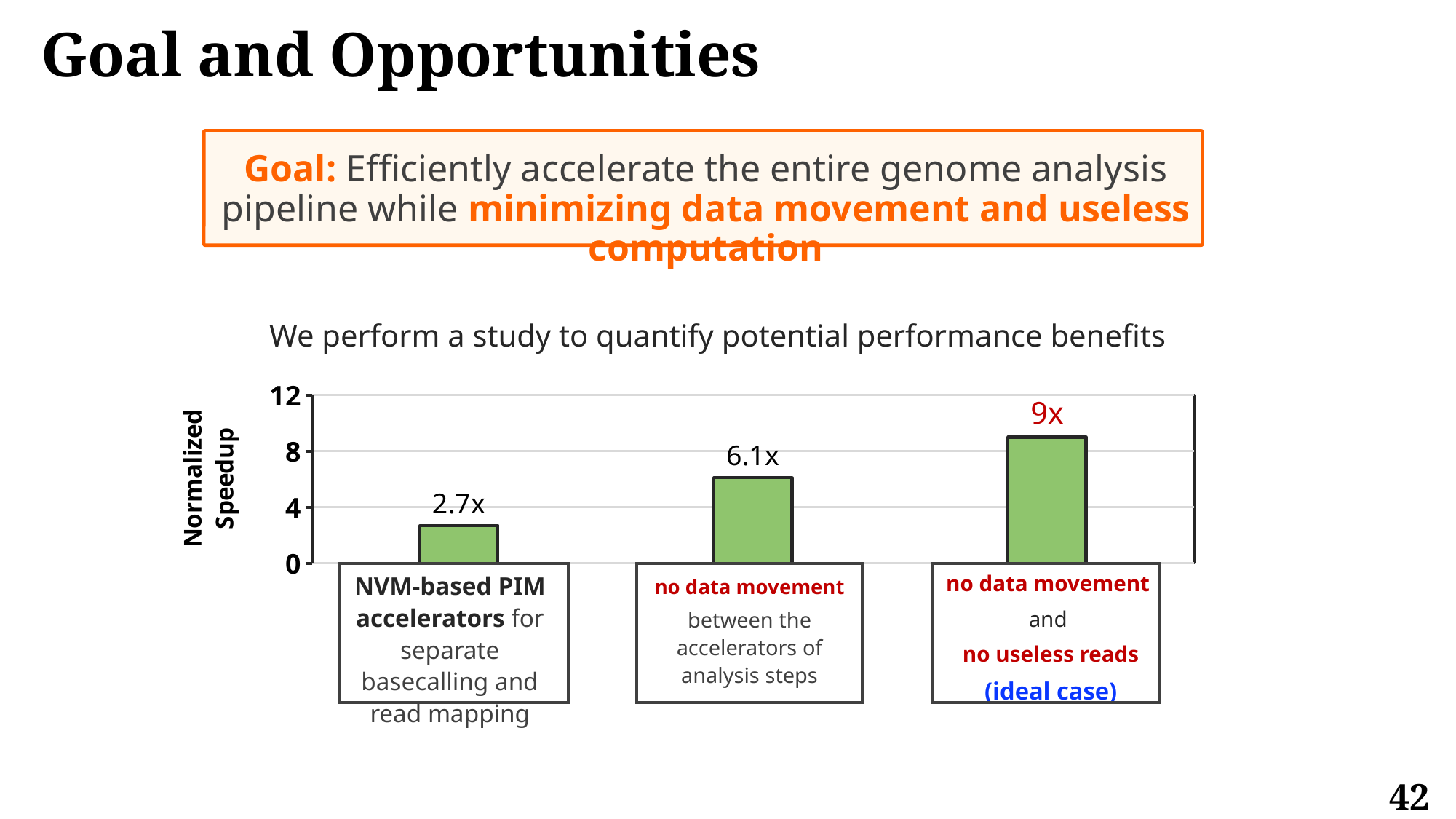
Which has a larger normalized speedup: NVM-based PIM accelerators or no data movement between accelerators? no data movement between accelerators What type of chart is shown on the slide? bar chart What is the label of the y-axis of the chart? Normalized Speedup Is the normalized speedup for the ideal case greater or less than 8? greater How many bars are shown in the chart? 3 What is the normalized speedup for NVM-based PIM accelerators for separate basecalling and read mapping? 2.7x Which configuration has the lowest normalized speedup? NVM-based PIM accelerators for separate basecalling and read mapping What is the normalized speedup in the ideal case with no data movement and no useless reads? 9x Which configuration has the highest normalized speedup? no data movement and no useless reads (ideal case) What is the difference in normalized speedup between the ideal case and the no data movement case? 2.9x What is the normalized speedup with no data movement between the accelerators of analysis steps? 6.1x What is the difference in normalized speedup between the no data movement case and the NVM-based PIM accelerators case? 3.4x